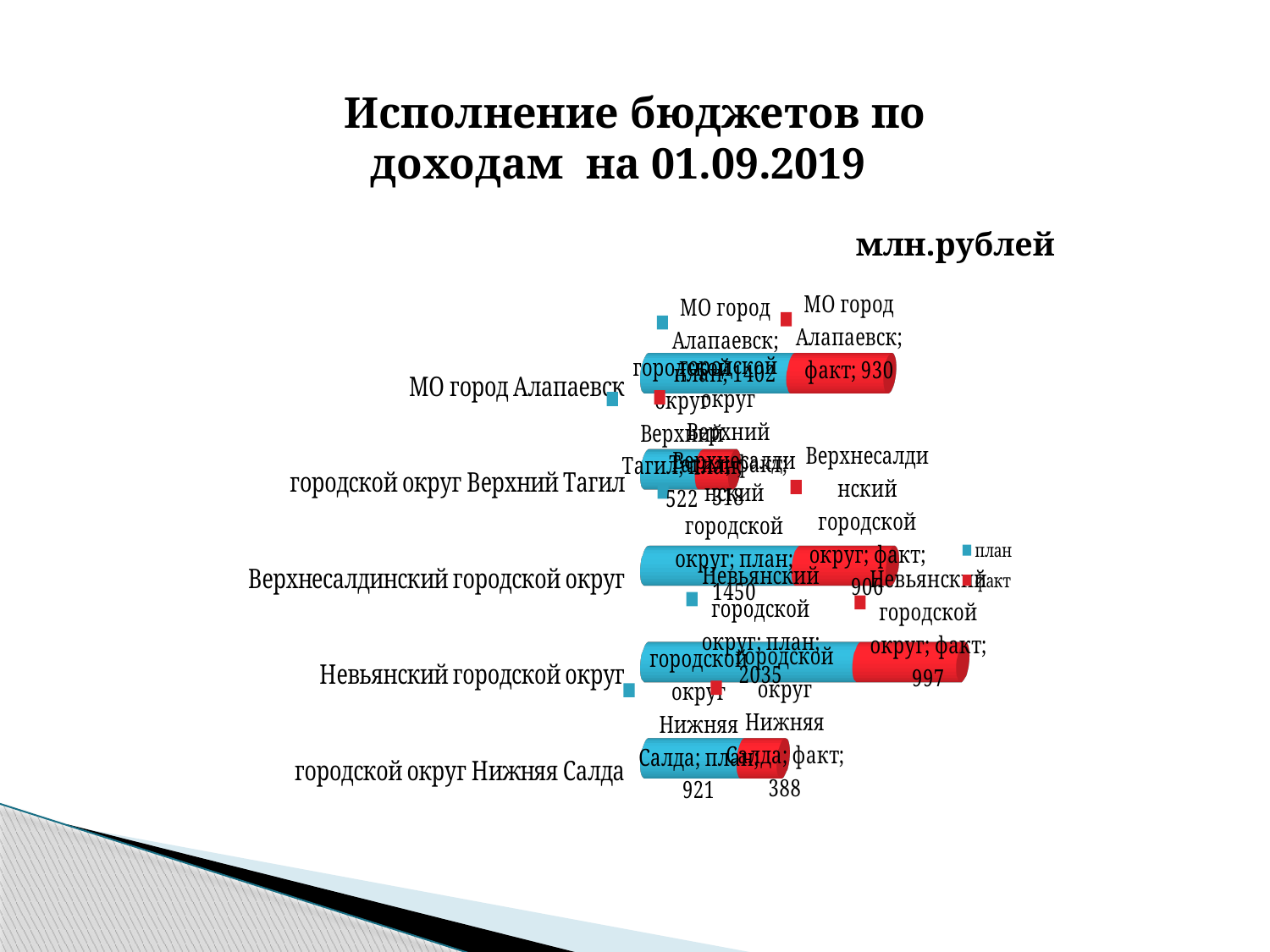
What is the difference between the план and факт values for Верхнесалдинский городской округ? 544 How many categories (municipalities) are shown on the chart? 5 Which is larger: the факт value for Невьянский городской округ or the факт value for МО город Алапаевск? Невьянский городской округ What is the план value for Невьянский городской округ? 2035 What is the факт value for городской округ Верхний Тагил? 318 What is the факт value for МО город Алапаевск? 930 What unit of measurement is stated for the chart values? млн.рублей What type of chart is shown on the slide? bar chart What is the план value for городской округ Нижняя Салда? 921 How many series does the legend list? 2 Which category has the highest план value? Невьянский городской округ Which category has the lowest факт value? городской округ Верхний Тагил